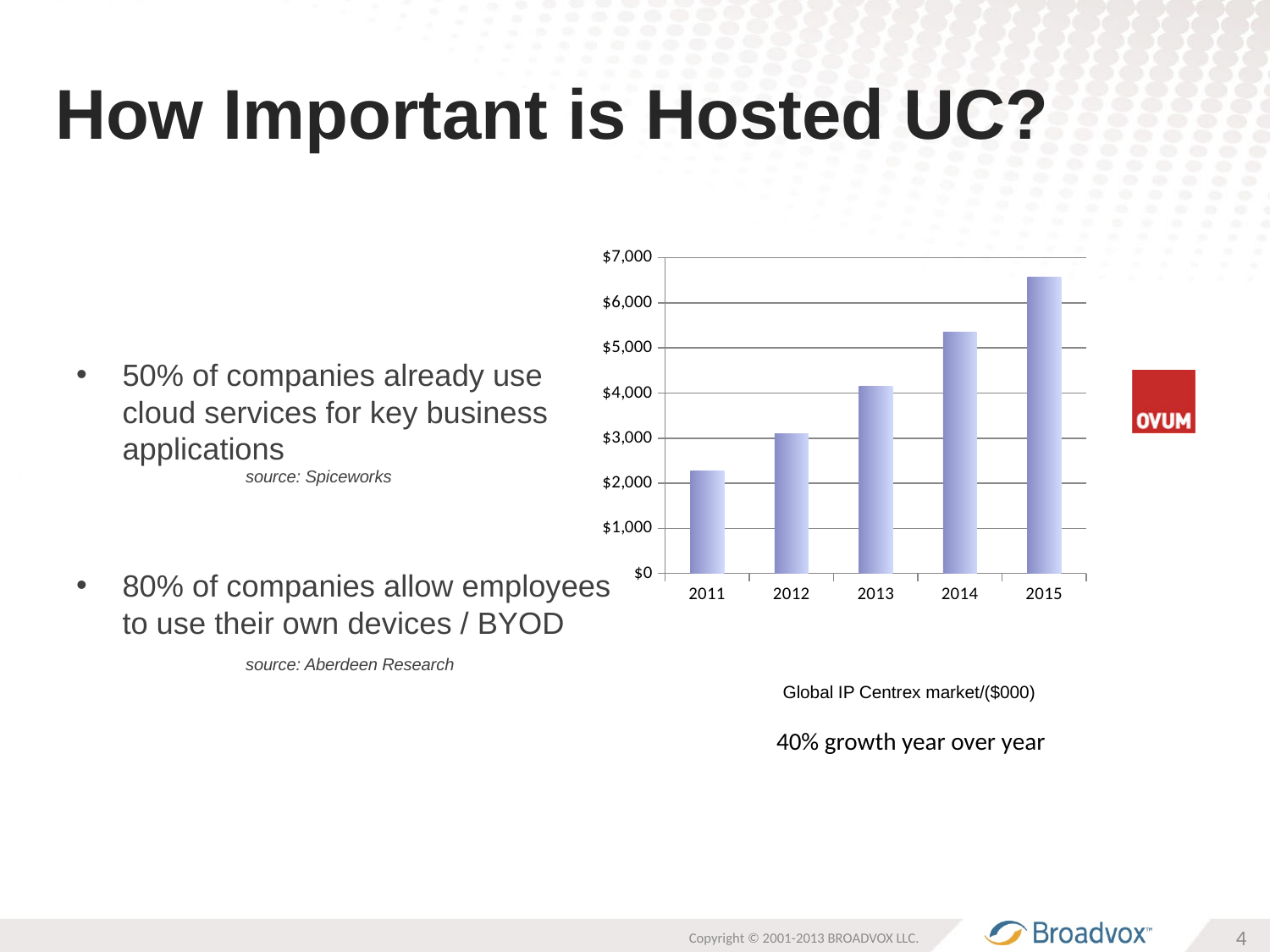
Is the value for 2013 greater or less than $5,000? less Is the value for 2012 greater or less than $4,000? less Which year has the highest value in the chart? 2015 Which is larger, the value for 2014 or the value for 2012? 2014 What kind of chart is shown on the slide? bar chart What caption describes the data shown in the chart? Global IP Centrex market/($000) Which year has the lowest value in the chart? 2011 Is the value for 2014 greater or less than $5,000? greater Do the values rise or fall from 2011 to 2015? rise How many years are shown on the x axis of the chart? 5